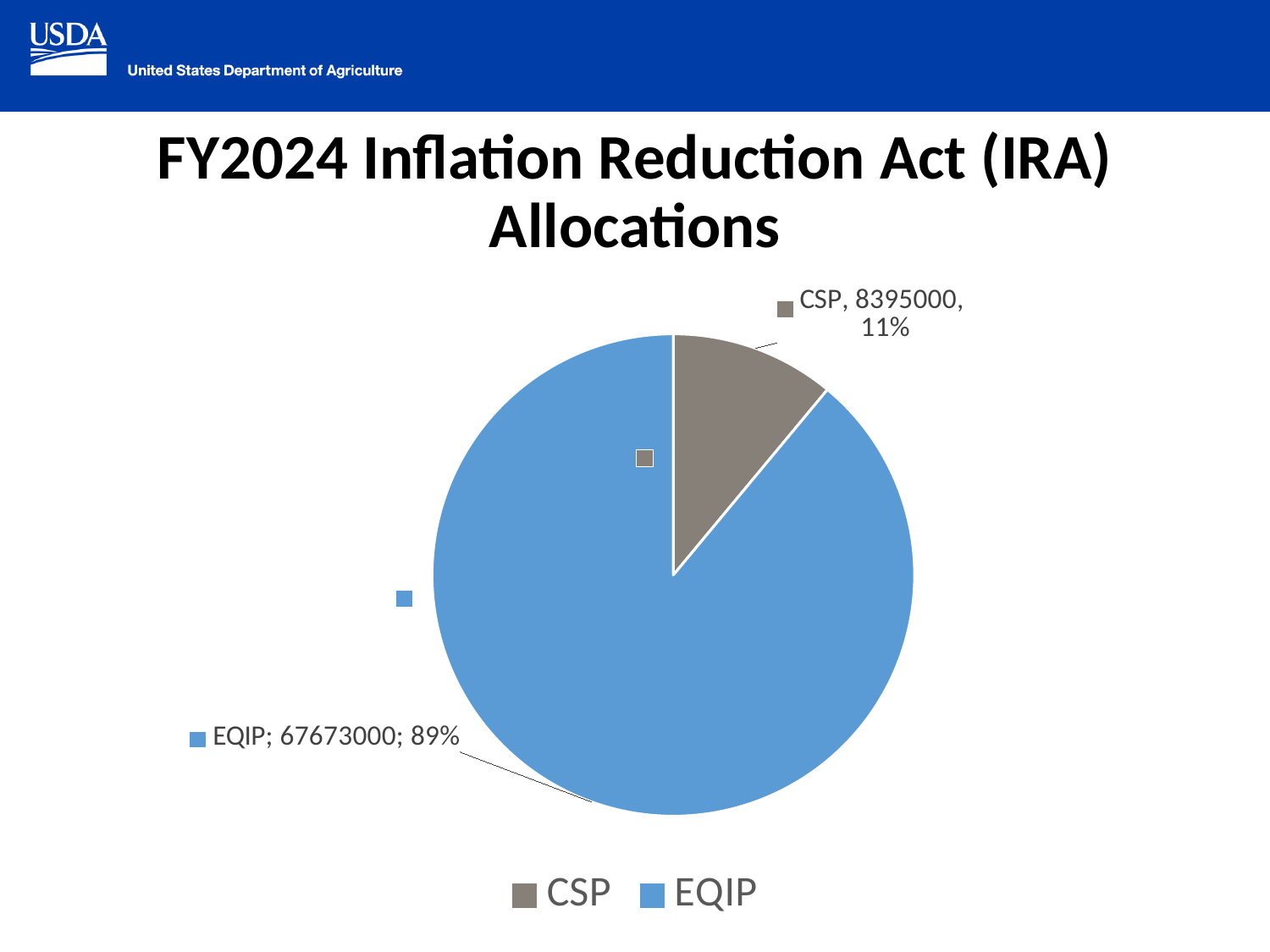
How many slices does the pie chart have? 2 How many entries does the legend list? 2 What is the difference between the EQIP and CSP allocations? 59278000 What is the allocation value for CSP? 8395000 Which program has the largest allocation? EQIP What is the allocation value for EQIP? 67673000 What is the title of the chart? FY2024 Inflation Reduction Act (IRA) Allocations What share of the pie does EQIP represent? 89% What kind of chart is shown on the slide? pie chart Which is larger, the allocation for CSP or for EQIP? EQIP Which program has the smallest allocation? CSP What share of the pie does CSP represent? 11%